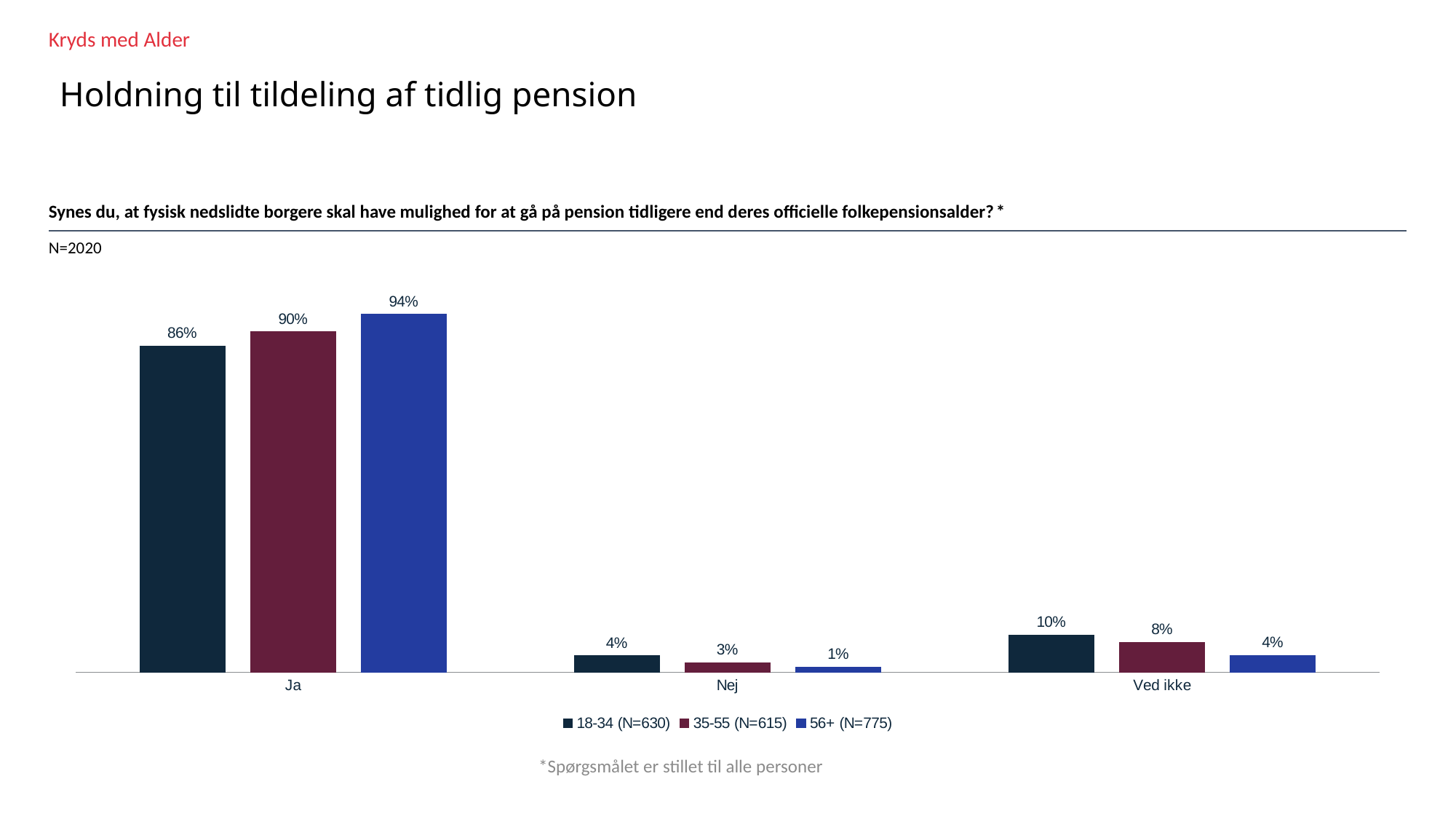
What percentage of the 18-34 age group answered "Ja"? 86% How many series does the legend list? 3 Which age group has the highest share answering "Ja"? 56+ (N=775) How many answer categories are shown on the x axis? 3 What is the difference between the 18-34 and 35-55 groups for "Ved ikke"? 2% Which is larger for the 18-34 group: the share answering "Nej" or "Ved ikke"? Ved ikke Which age group has the lowest share answering "Ved ikke"? 56+ (N=775) What is the difference between the 56+ and 18-34 groups for "Ja"? 8% What percentage of the 56+ age group answered "Nej"? 1% What kind of chart is shown on the slide? Bar chart What percentage of the 35-55 age group answered "Ved ikke"? 8% What is the sample size (N) stated for the 35-55 age group in the legend? 615